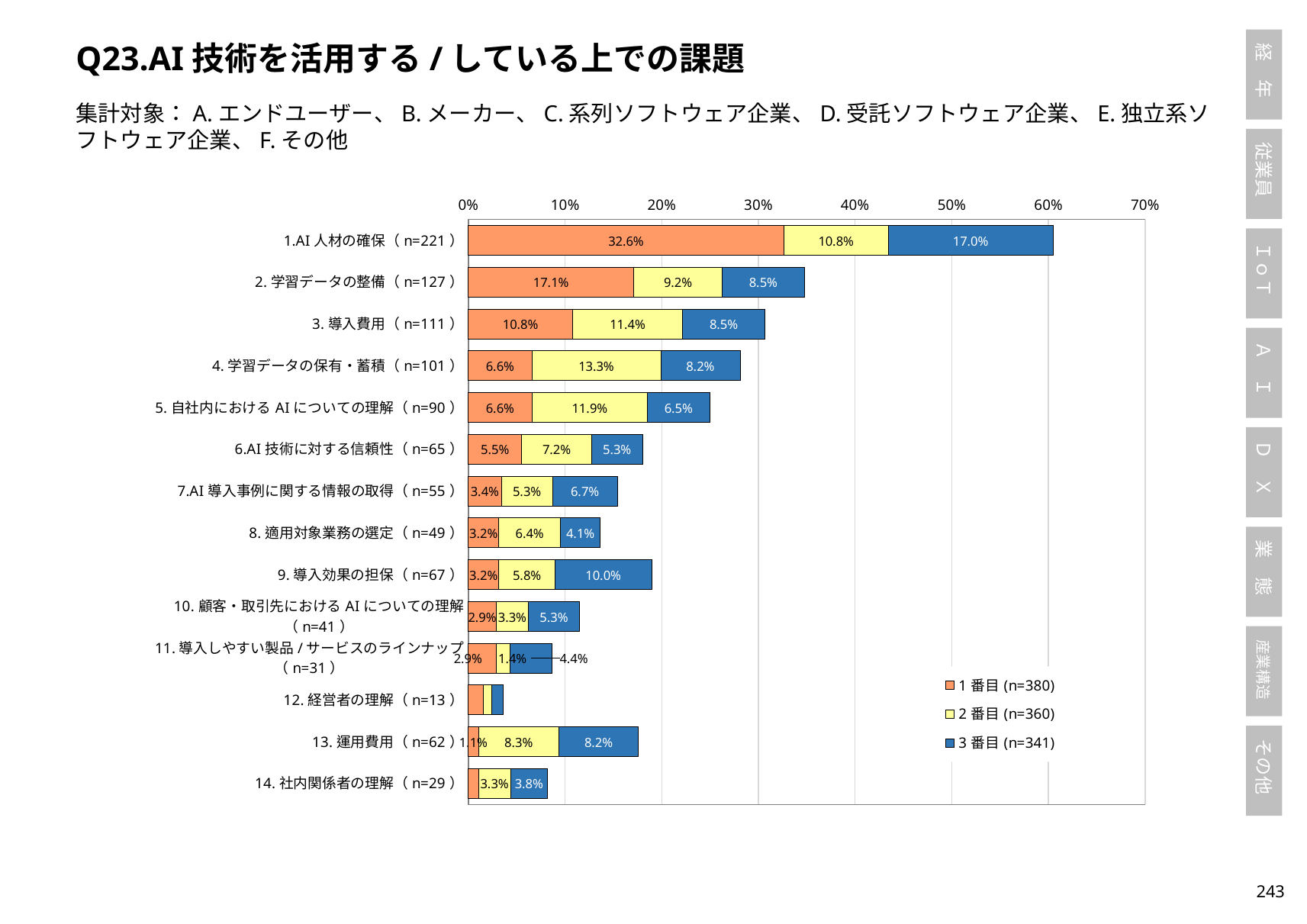
What is the difference between the 1番目 values for 1.AI人材の確保 and 2.学習データの整備? 15.5% What is the n value shown in the legend for the 1番目 series? n=380 How many categories are plotted on the chart? 14 What is the total of the stacked bar for 2.学習データの整備 (n=127)? 34.8% What kind of chart is shown on the slide? Stacked horizontal bar chart What is the 1番目 value for 1.AI人材の確保 (n=221)? 32.6% Which category has the highest 1番目 value? 1.AI人材の確保 (n=221) Is the total stacked bar for 1.AI人材の確保 (n=221) greater or less than 50%? greater Which is larger: the 3番目 value for 9.導入効果の担保 or the 3番目 value for 6.AI技術に対する信頼性? 9.導入効果の担保 What is the 2番目 value for 4.学習データの保有・蓄積 (n=101)? 13.3% How many series does the legend list? 3 What is the 3番目 value for 9.導入効果の担保 (n=67)? 10.0%